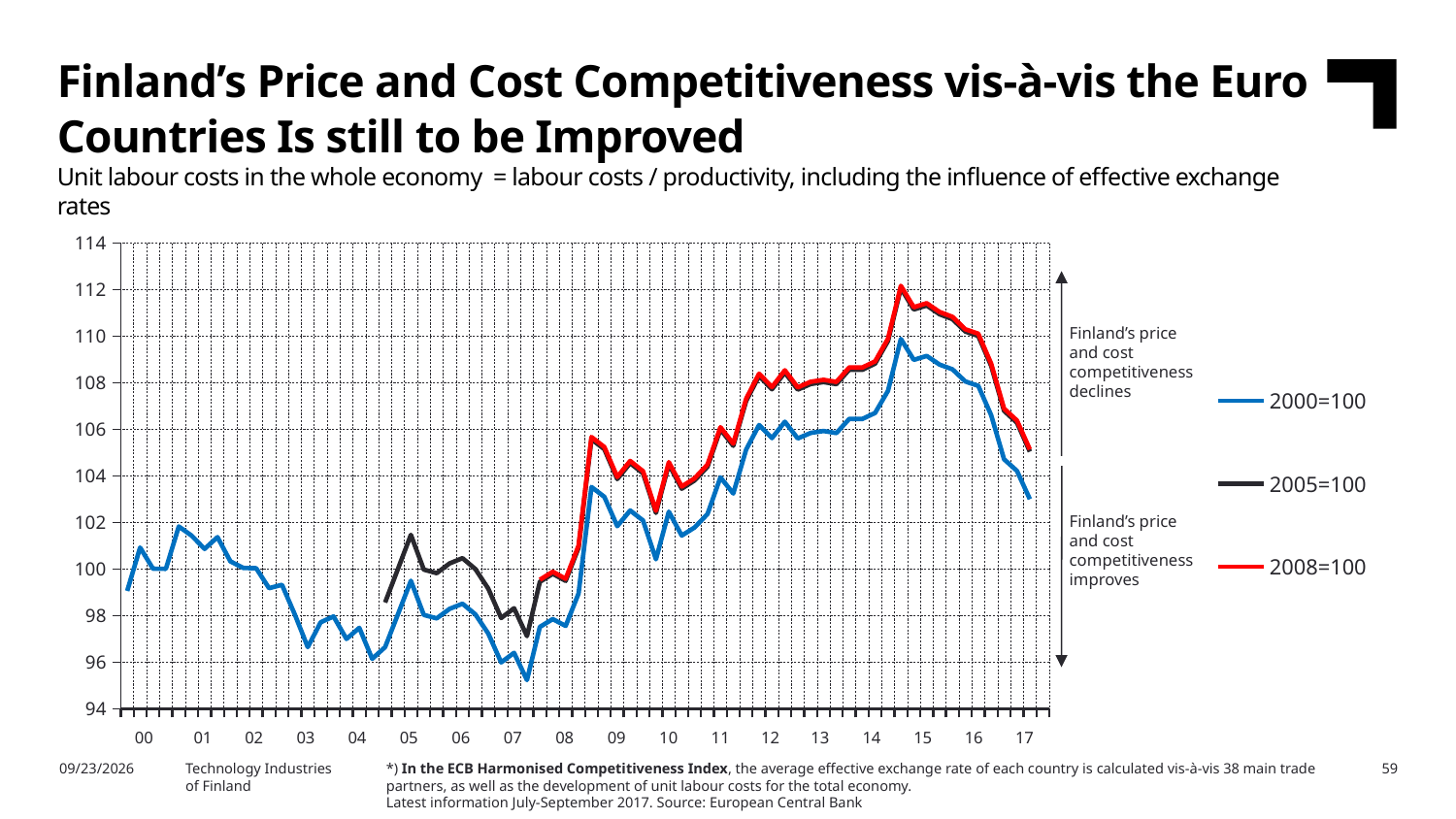
Do the values of the 2000=100 series rise or fall between 2015 and 2017? fall Is the lowest value of the 2000=100 series, around 2007, greater or less than 98? less Is the value of the 2000=100 series at the start of 2000 greater or less than 100? less How many series does the legend list? 3 Which series is drawn in red? 2008=100 Which series reaches the highest value on the chart? 2008=100 Is the final value of the 2008=100 series in 2017 greater or less than 104? greater Around 2015, which series is higher: 2008=100 or 2000=100? 2008=100 How many year labels are shown along the x axis? 18 What kind of chart is shown on the slide? line chart